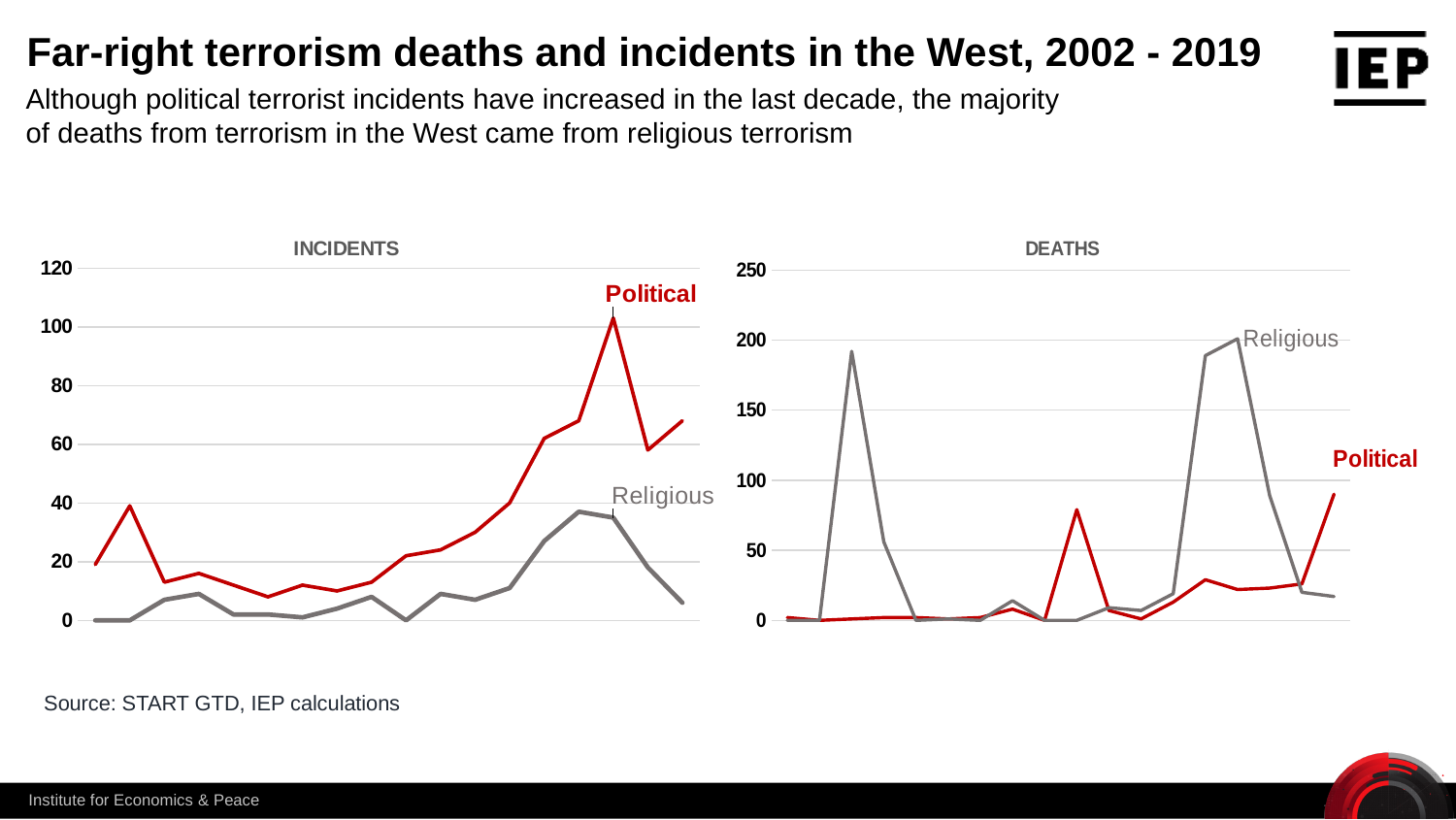
What is the highest value shown on the y axis of the DEATHS chart? 250 On the INCIDENTS chart, does the Political line overall rise or fall from left to right? rise On the DEATHS chart, which series reaches the higher peak, Political or Religious? Religious How many charts are shown on the slide? 2 How many series are plotted on the INCIDENTS chart? 2 On the DEATHS chart, is the highest value of the Religious line greater or less than 150? greater On the DEATHS chart, which series is drawn in red? Political On the DEATHS chart, is the highest value of the Political line greater or less than 100? less What kind of chart is the INCIDENTS chart? line chart On the INCIDENTS chart, is the highest value of the Political line greater or less than 100? greater On the INCIDENTS chart, which series reaches the higher peak, Political or Religious? Political